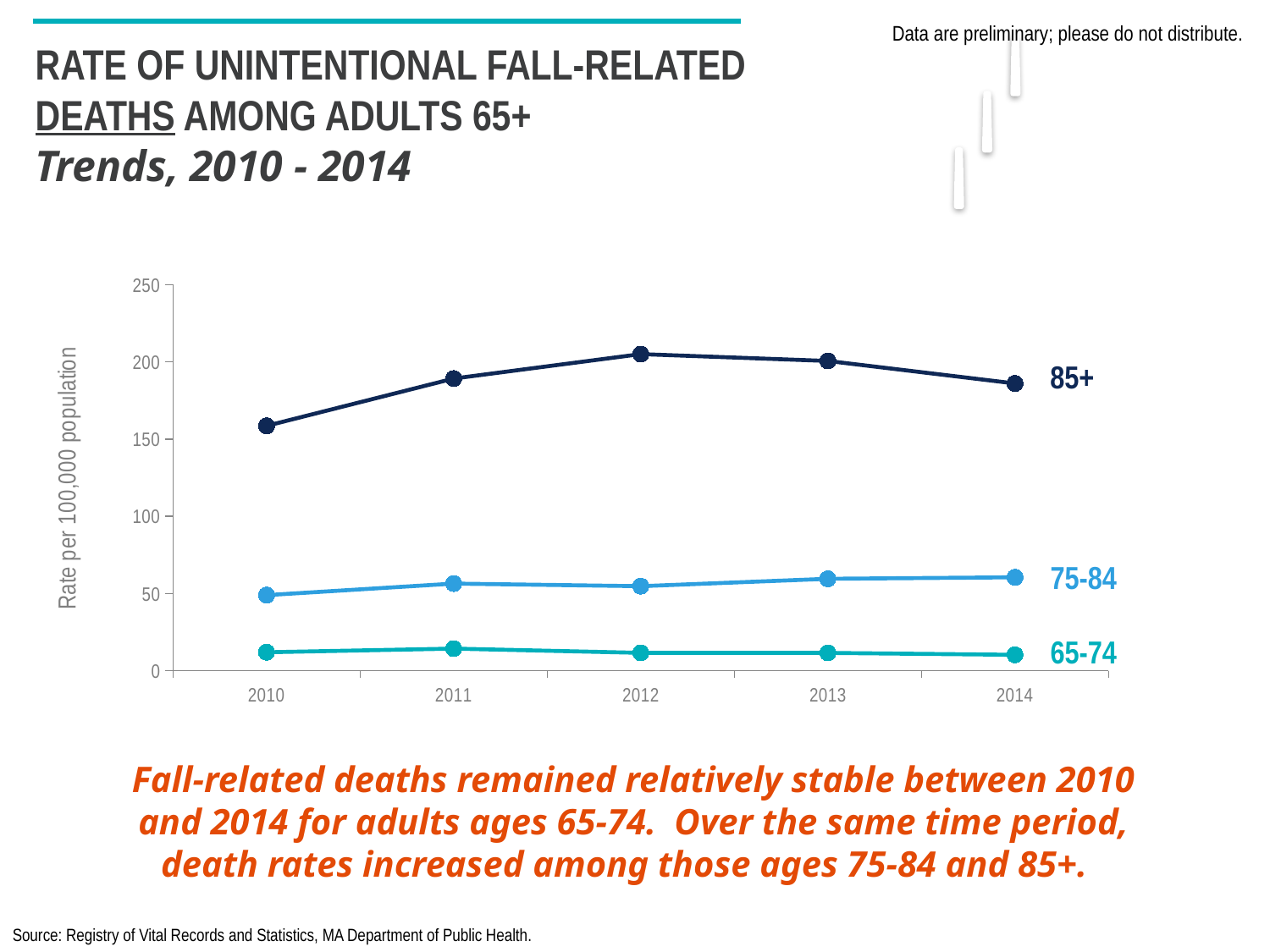
What is the label on the y axis of the chart? Rate per 100,000 population Is the 2010 value for the 85+ age group greater or less than 150? greater Is the 2014 value for the 85+ age group greater or less than 200? less Does the rate for the 85+ age group rise or fall between 2010 and 2012? rise Which age group has the lowest fall-related death rate across all years shown? 65-74 Is the 2013 value for the 75-84 age group greater or less than 50? greater What kind of chart is shown on the slide? Line chart How many years are shown along the x axis of the chart? 5 In 2014, which age group has the larger death rate, 85+ or 75-84? 85+ Which age group has the highest fall-related death rate across all years shown? 85+ How many age-group series are plotted on the chart? 3